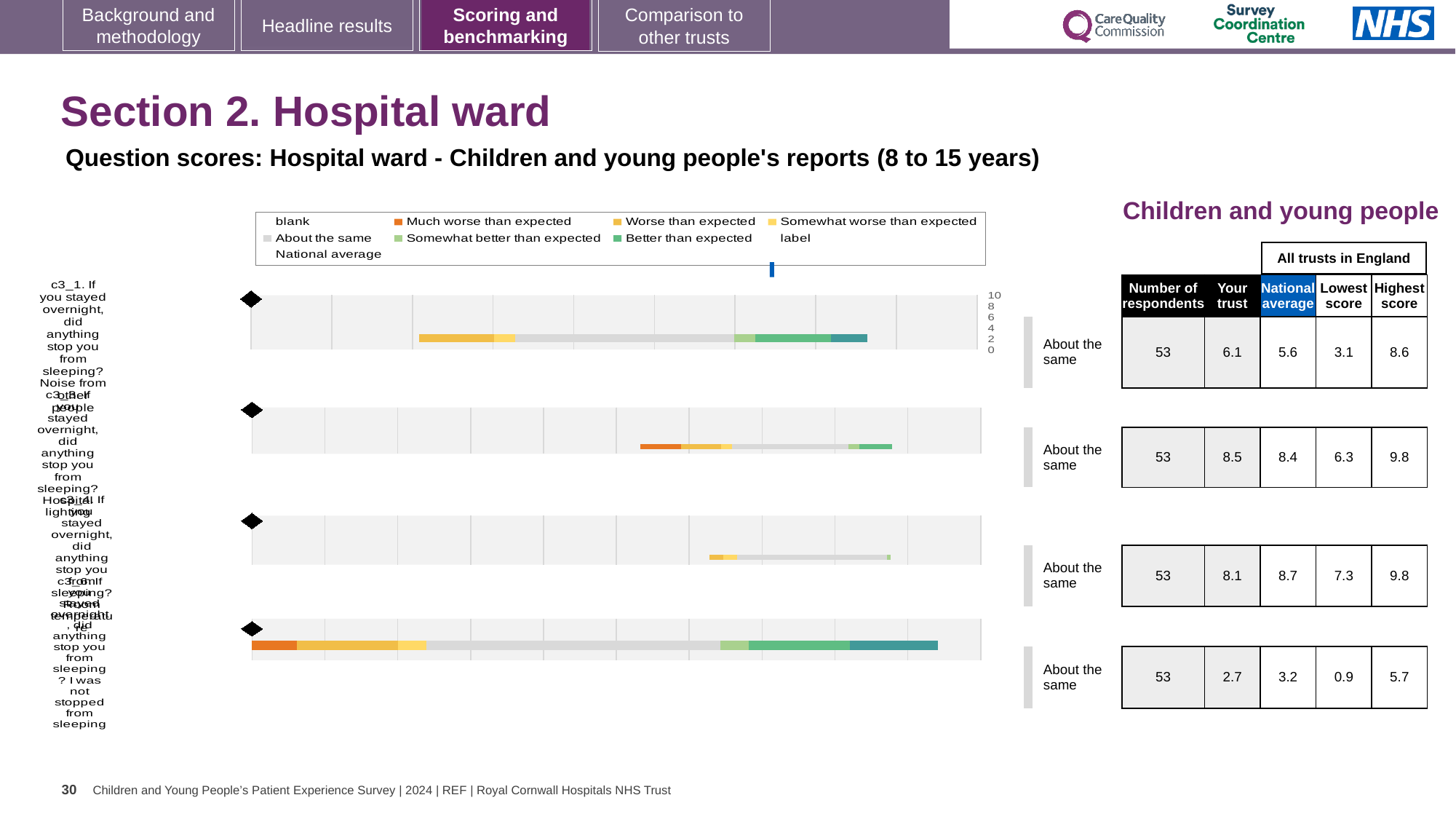
How many questions (bars) are plotted in the chart? 4 According to the table, which question has the highest 'Your trust' score? c3_3 (Hospital lighting) What colour represents 'Much worse than expected' in the chart legend? orange What kind of chart is shown on the slide? bar chart What colour represents 'About the same' in the chart legend? grey In the table beside the chart, what is the national average for c3_4 (Room temperature)? 8.7 In the table beside the chart, what is the 'Your trust' score for c3_1 (Noise from other people)? 6.1 According to the table, which question has the lowest 'Your trust' score? c3_6 (I was not stopped from sleeping) How many entries does the chart legend list? 9 For c3_1, is the 'Your trust' score or the national average larger? Your trust What is the difference between the 'Your trust' scores for c3_3 (8.5) and c3_6 (2.7)? 5.8